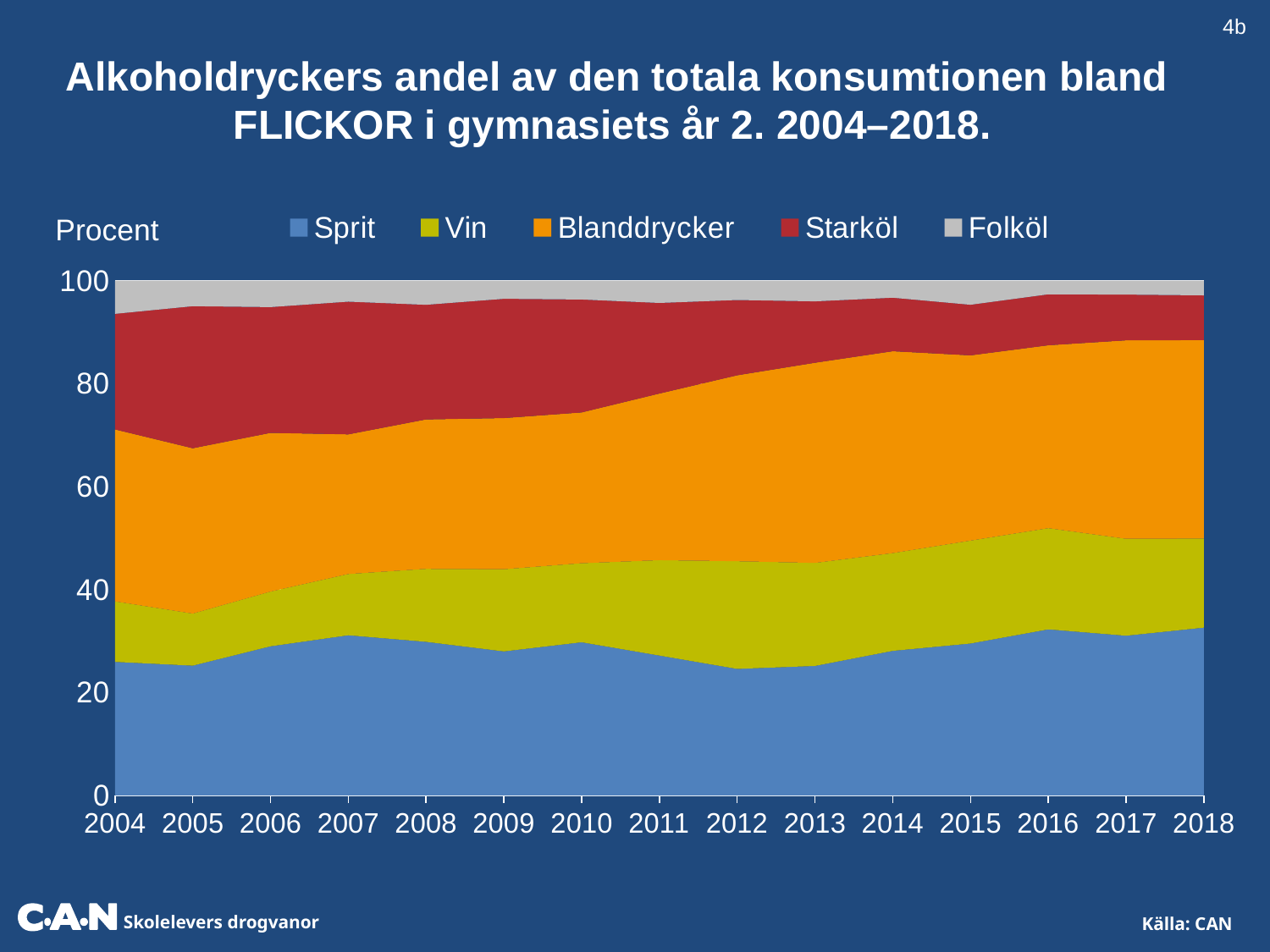
How many years are shown along the x axis? 15 What label is shown on the y axis? Procent Is the value for Sprit in 2004 greater or less than 40? less Is the Starköl band thicker in 2004 or in 2018? 2004 Is the cumulative top of the Blanddrycker band in 2018 greater or less than 80? greater Is the Sprit share larger in 2004 or in 2018? 2018 Does the Starköl share rise or fall from 2004 to 2018? Fall How many series does the legend list? 5 Is the value for Sprit in 2018 greater or less than 20? greater What kind of chart is shown on the slide? Stacked area chart Which series is listed first in the legend? Sprit